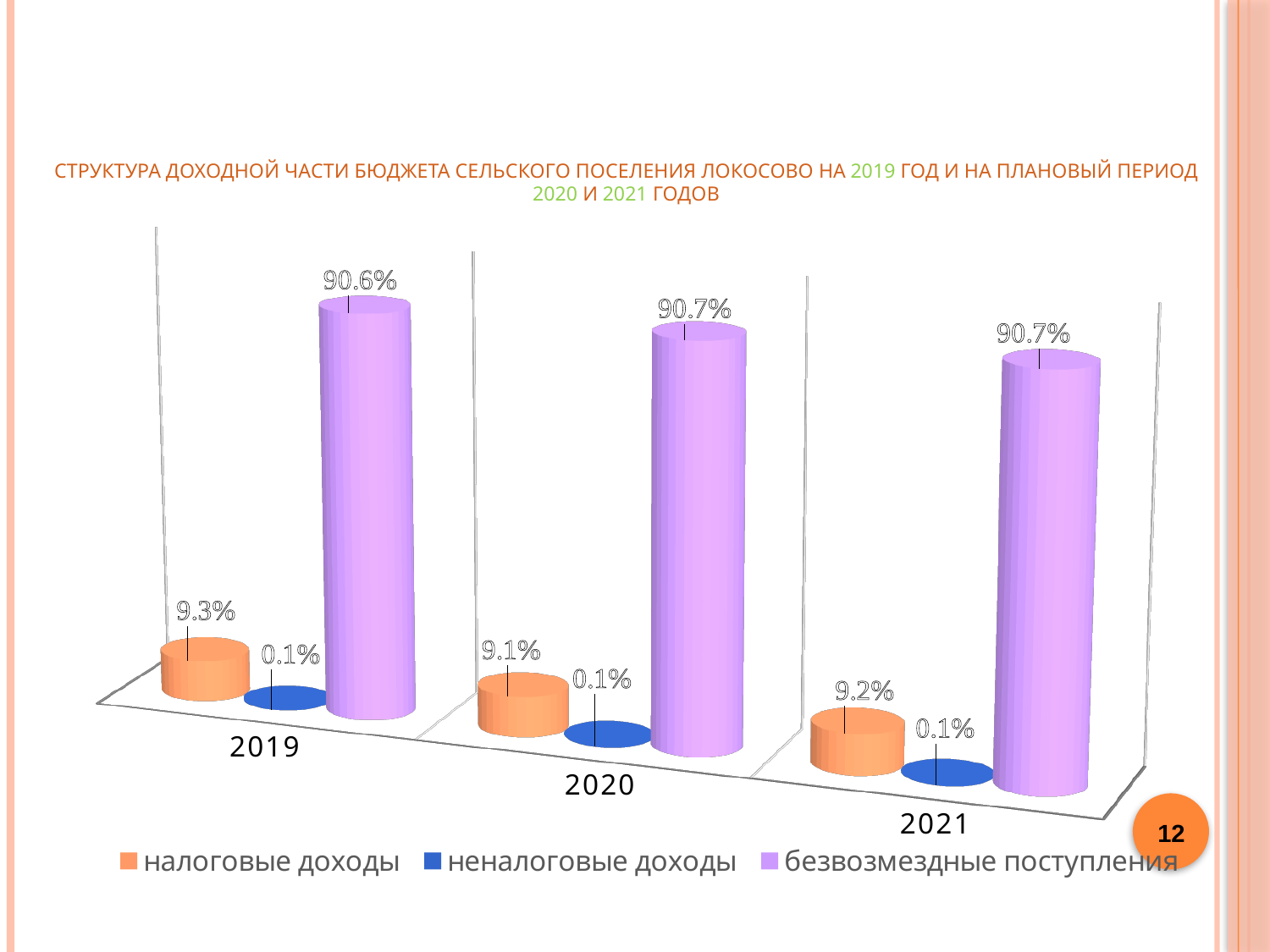
What is the value for безвозмездные поступления in 2020? 90.7% Which year has the highest value for налоговые доходы? 2019 What is the value for неналоговые доходы in 2021? 0.1% What is the difference between безвозмездные поступления in 2020 and in 2019? 0.1% Which year has the lowest value for налоговые доходы? 2020 What is the value for налоговые доходы in 2019? 9.3% Which is larger in 2019: налоговые доходы or неналоговые доходы? налоговые доходы How many series does the legend list? 3 Which colour represents безвозмездные поступления in the legend? purple What is the value for налоговые доходы in 2021? 9.2% What kind of chart is shown on the slide? bar chart How many years are shown on the x axis? 3